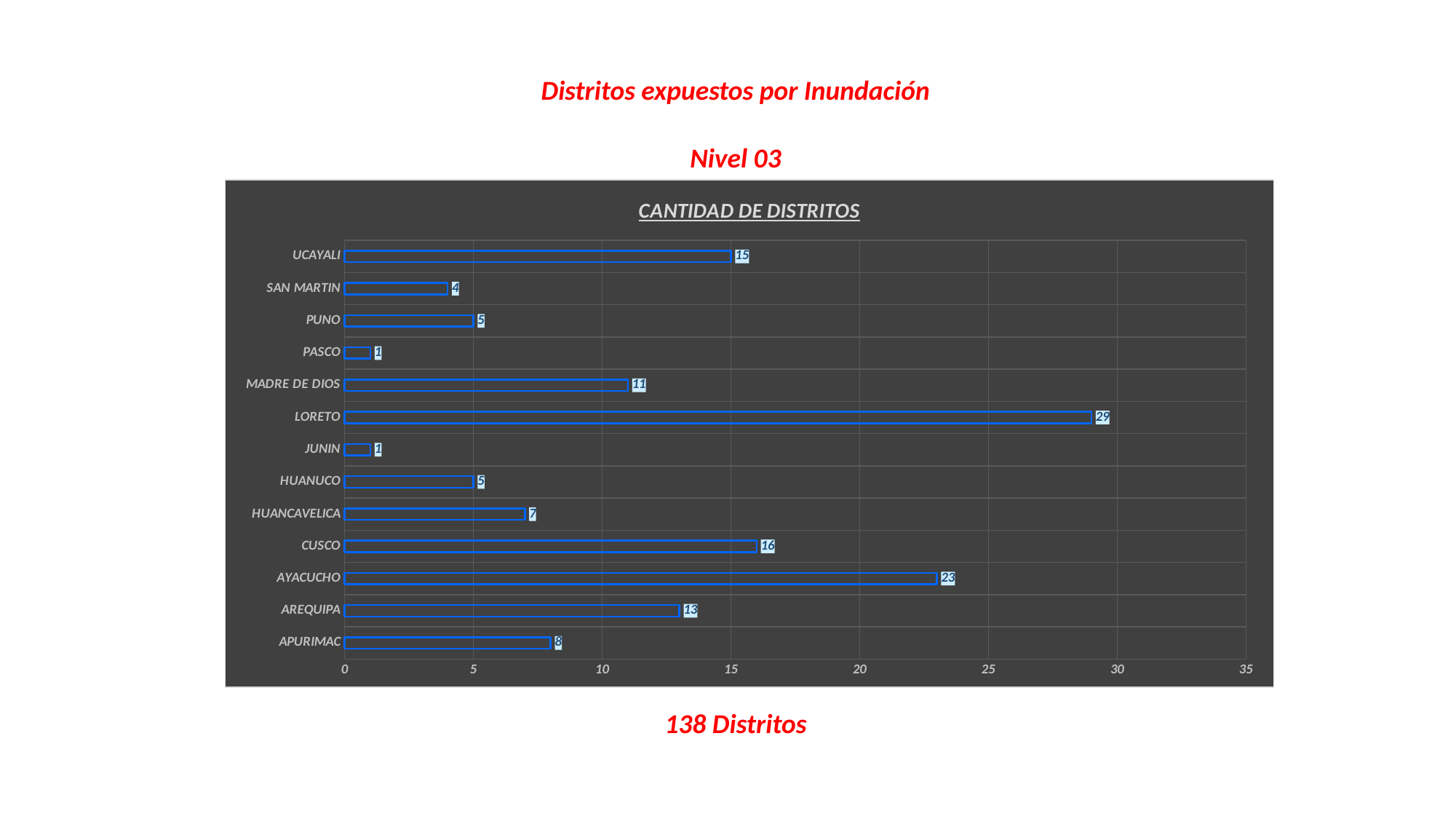
What is the difference between the values for AYACUCHO and CUSCO? 7 Which is larger, the value for UCAYALI or the value for APURIMAC? UCAYALI How many categories are shown on the chart? 13 Which category has the highest value? LORETO What is the difference between the values for LORETO and PASCO? 28 What is the value for MADRE DE DIOS? 11 What is the value for SAN MARTIN? 4 What is the value for LORETO? 29 What is the value for AREQUIPA? 13 What is the title of the chart? CANTIDAD DE DISTRITOS What kind of chart is shown? bar chart Is the value for HUANCAVELICA greater or less than 10? less